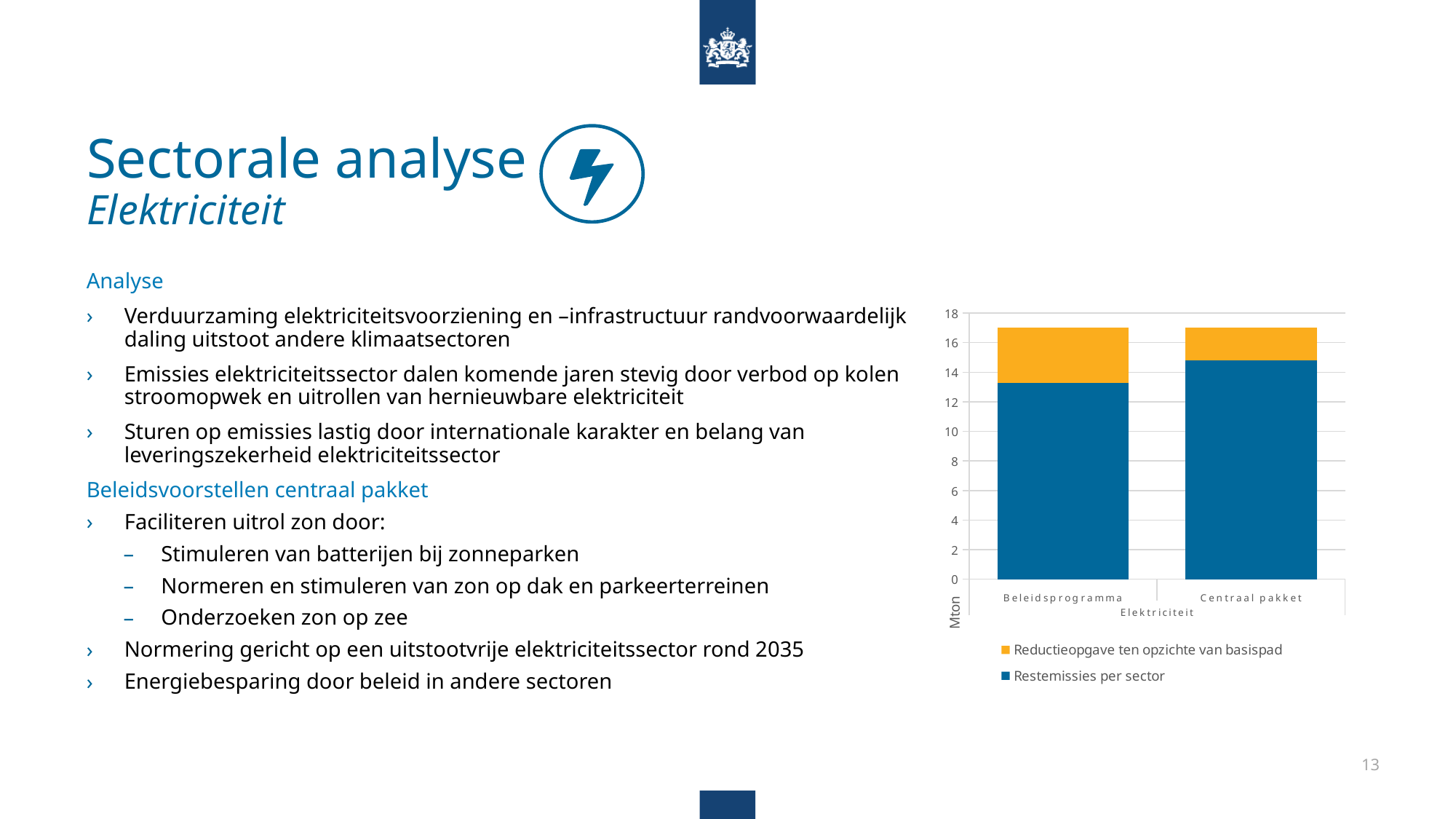
Is the total height of the Centraal pakket bar greater or less than 18? less Which category has the larger Reductieopgave ten opzichte van basispad value, Beleidsprogramma or Centraal pakket? Beleidsprogramma What kind of chart is shown on the slide? stacked bar chart Which category has the larger Restemissies per sector value, Beleidsprogramma or Centraal pakket? Centraal pakket What unit is shown on the vertical axis of the chart? Mton How many categories are shown on the x axis of the chart? 2 Which series is shown in orange in the chart? Reductieopgave ten opzichte van basispad Is the Restemissies per sector value for Beleidsprogramma greater or less than 14? less Is the Restemissies per sector value for Beleidsprogramma greater or less than 12? greater How many series does the chart's legend list? 2